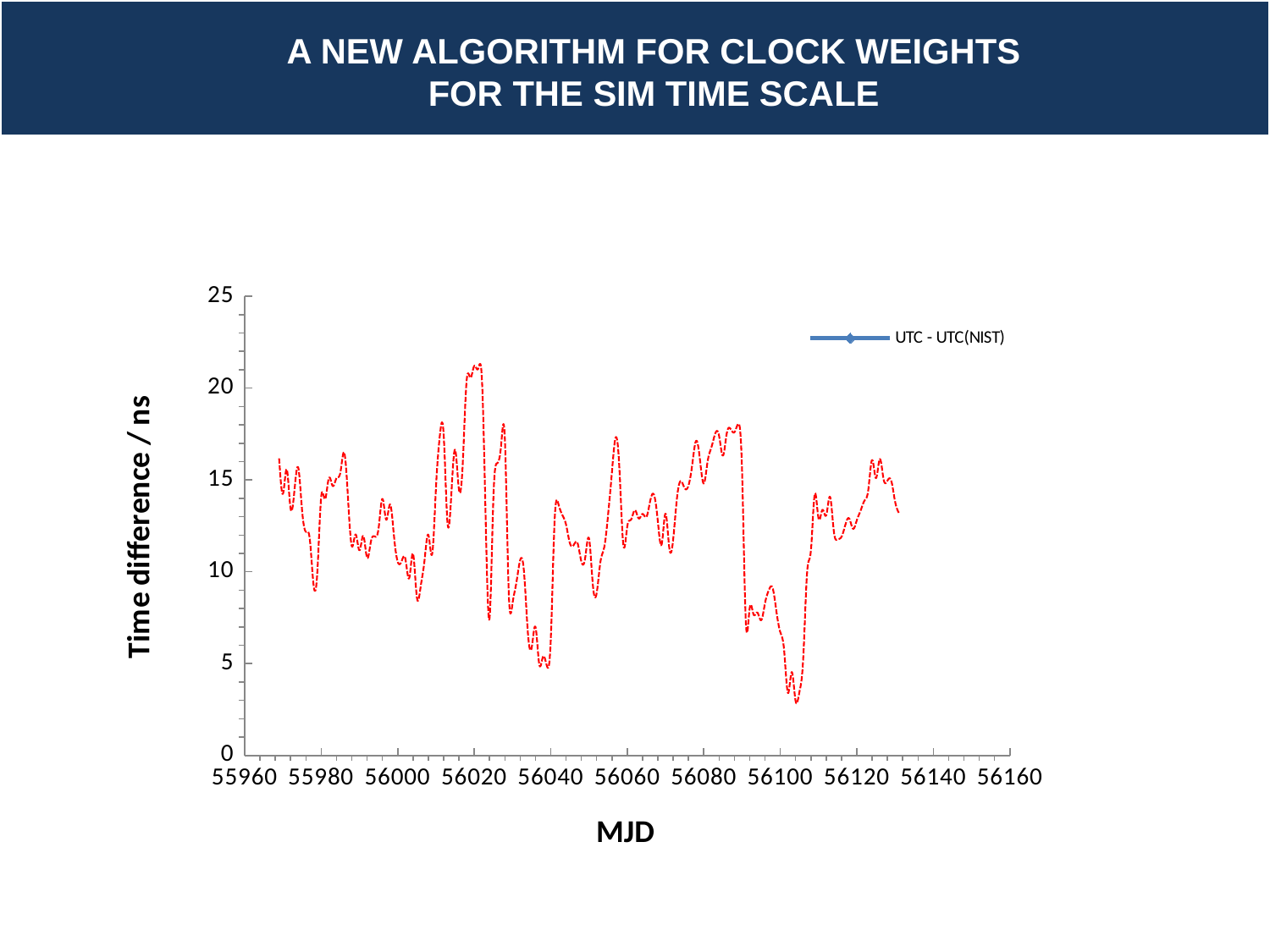
How many series does the legend list? 1 Is the value of the line at MJD 56080 greater or less than 10? greater Around which x-axis tick does the line reach its lowest value? 56100 Is the lowest value of the line, near MJD 56104, greater or less than 5? less Which is larger: the value of the line near MJD 56020 or the value near MJD 56104? near MJD 56020 Around which x-axis tick does the line reach its highest value? 56020 Is the value of the line at MJD 56100 greater or less than 10? less What is the label of the vertical axis? Time difference / ns What series name is shown in the legend? UTC - UTC(NIST) What kind of chart is shown on the slide? line chart